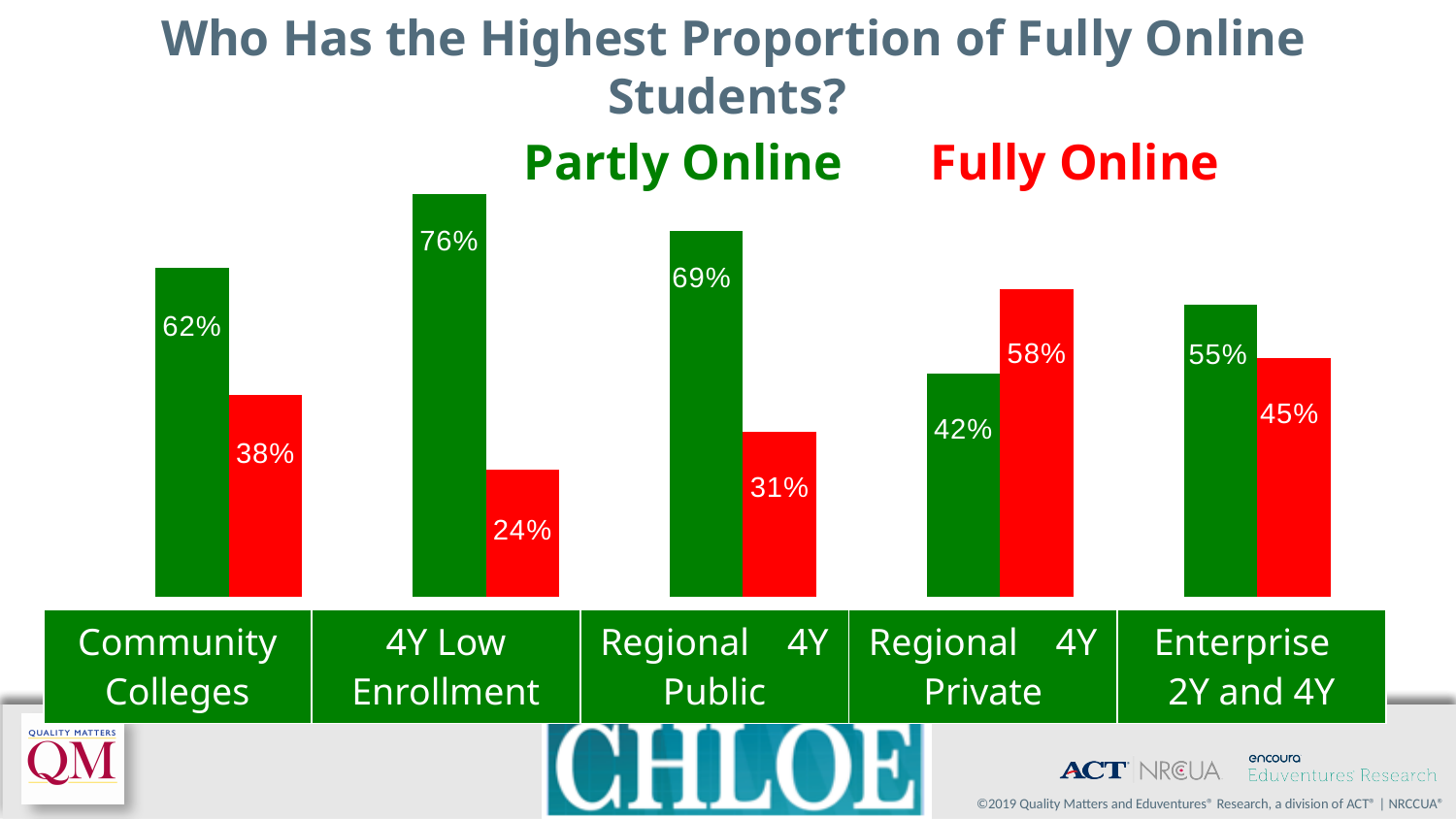
What is the Fully Online value for Regional 4Y Private? 58% What is the Fully Online value for Community Colleges? 38% How many categories are shown on the x axis? 5 Which category has the highest Partly Online value? 4Y Low Enrollment What is the Partly Online value for 4Y Low Enrollment? 76% What is the difference between the Partly Online and Fully Online values for Regional 4Y Public? 38% Which is larger for Regional 4Y Private: the Partly Online value or the Fully Online value? Fully Online How many series does the chart show? 2 What is the Partly Online value for Enterprise 2Y and 4Y? 55% Which category has the lowest Fully Online value? 4Y Low Enrollment What kind of chart is shown on the slide? Bar chart Which category has the highest Fully Online value? Regional 4Y Private